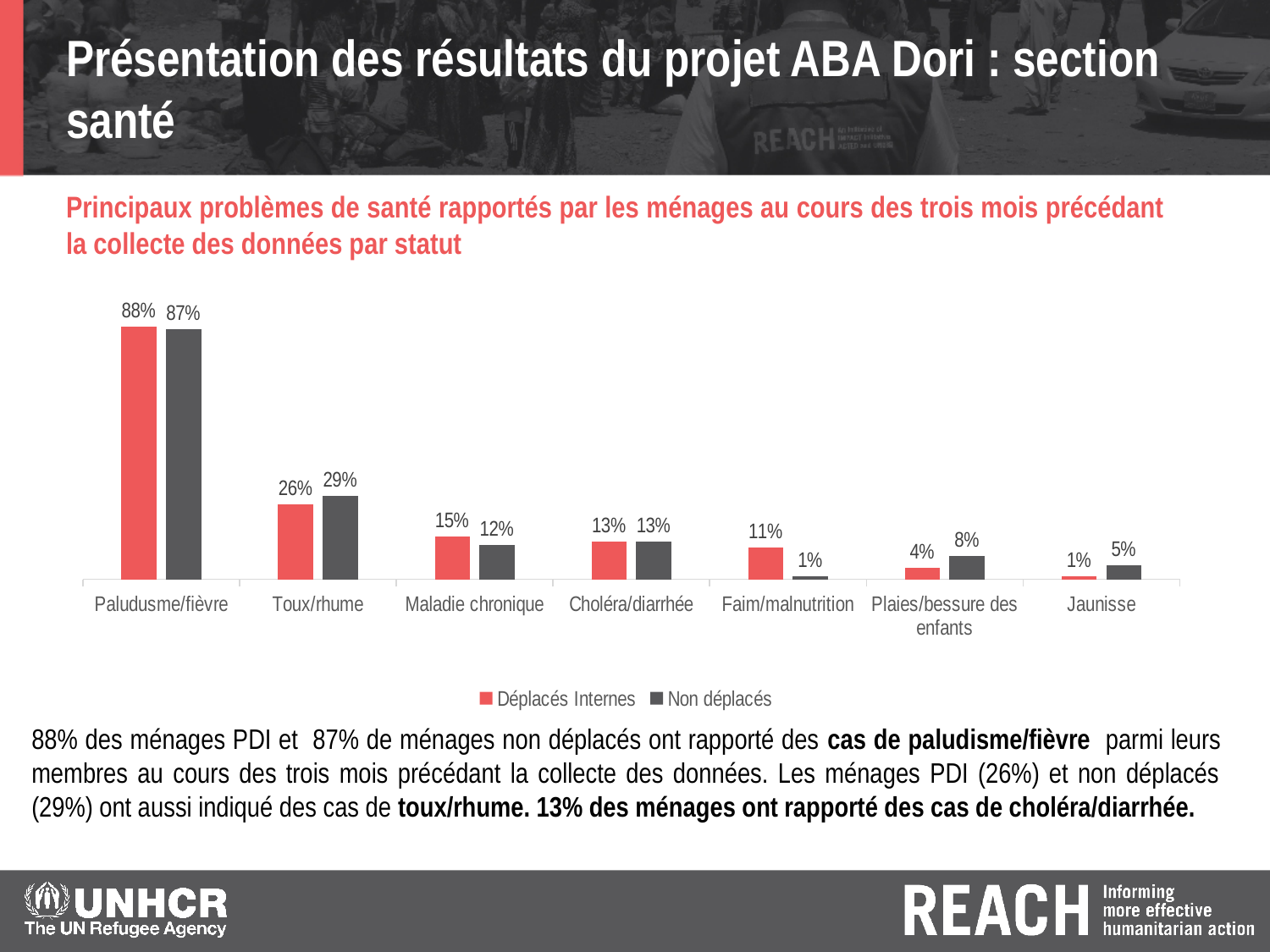
What is the value for Déplacés Internes for Faim/malnutrition? 11% How many series does the legend list? 2 Which category has the highest value for Non déplacés? Paludusme/fièvre Which category has the lowest value for Déplacés Internes? Jaunisse What is the value for Non déplacés for Toux/rhume? 29% What is the difference between the Déplacés Internes and Non déplacés values for Faim/malnutrition? 10% Which colour represents Déplacés Internes in the chart? Red How many categories are shown on the x axis? 7 What percentage of Déplacés Internes households reported Paludusme/fièvre? 88% For Plaies/bessure des enfants, which series has the larger value: Déplacés Internes or Non déplacés? Non déplacés What is the value for Non déplacés for Jaunisse? 5% What kind of chart is shown on the slide? Bar chart